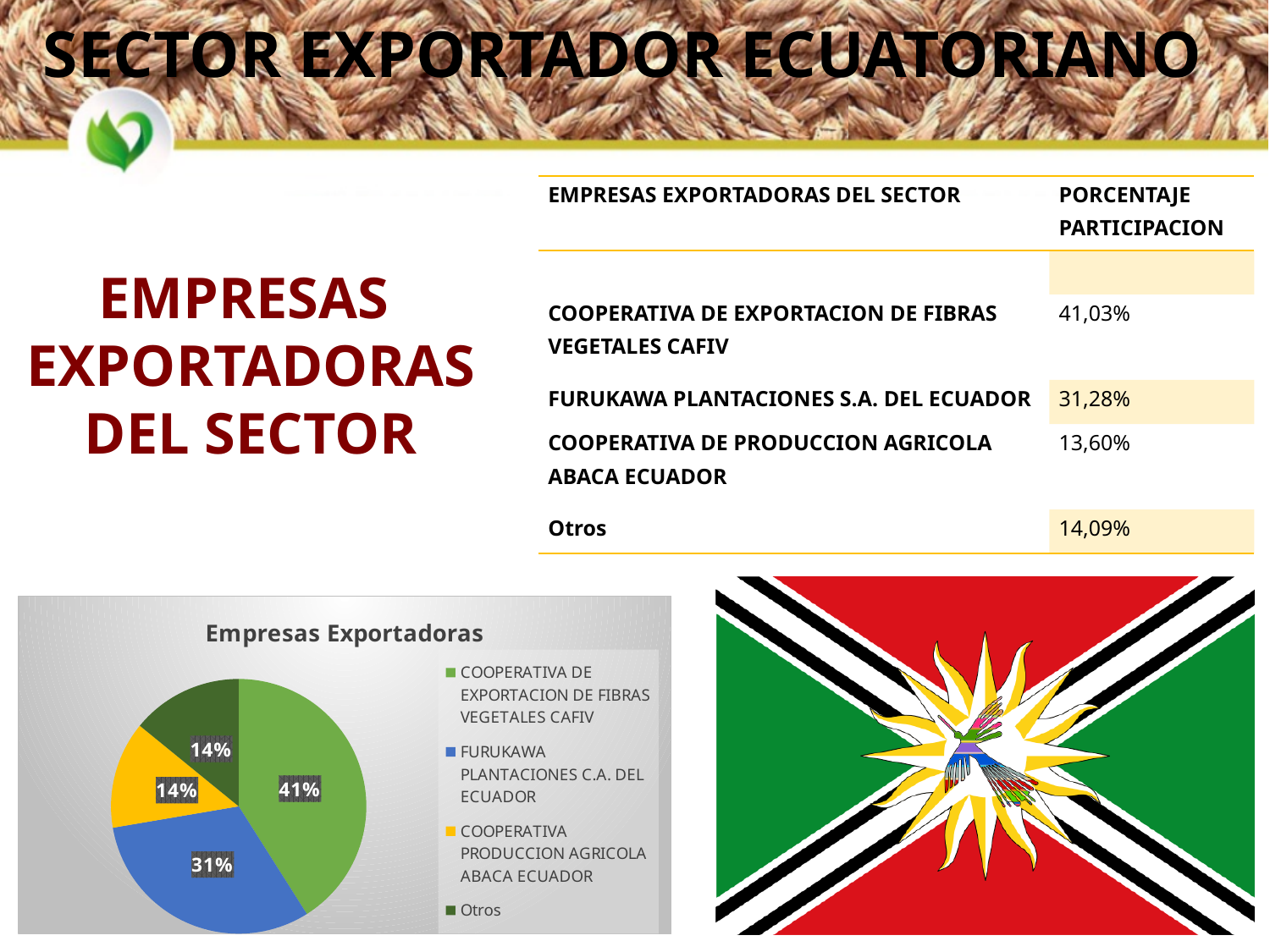
Which slice is larger: COOPERATIVA DE EXPORTACION DE FIBRAS VEGETALES CAFIV or FURUKAWA PLANTACIONES C.A. DEL ECUADOR? COOPERATIVA DE EXPORTACION DE FIBRAS VEGETALES CAFIV What share of the pie does COOPERATIVA DE EXPORTACION DE FIBRAS VEGETALES CAFIV hold? 41% Which company has the largest slice of the pie chart? COOPERATIVA DE EXPORTACION DE FIBRAS VEGETALES CAFIV What kind of chart is shown on the slide? pie chart How many slices does the pie chart have? 4 What share of the pie does COOPERATIVA PRODUCCION AGRICOLA ABACA ECUADOR hold? 14% What is the title of the pie chart? Empresas Exportadoras How many entries does the legend of the pie chart list? 4 What share of the pie does Otros hold? 14% What colour is the slice for FURUKAWA PLANTACIONES C.A. DEL ECUADOR in the pie chart? blue By how many percentage points does the CAFIV slice exceed the FURUKAWA PLANTACIONES slice? 10